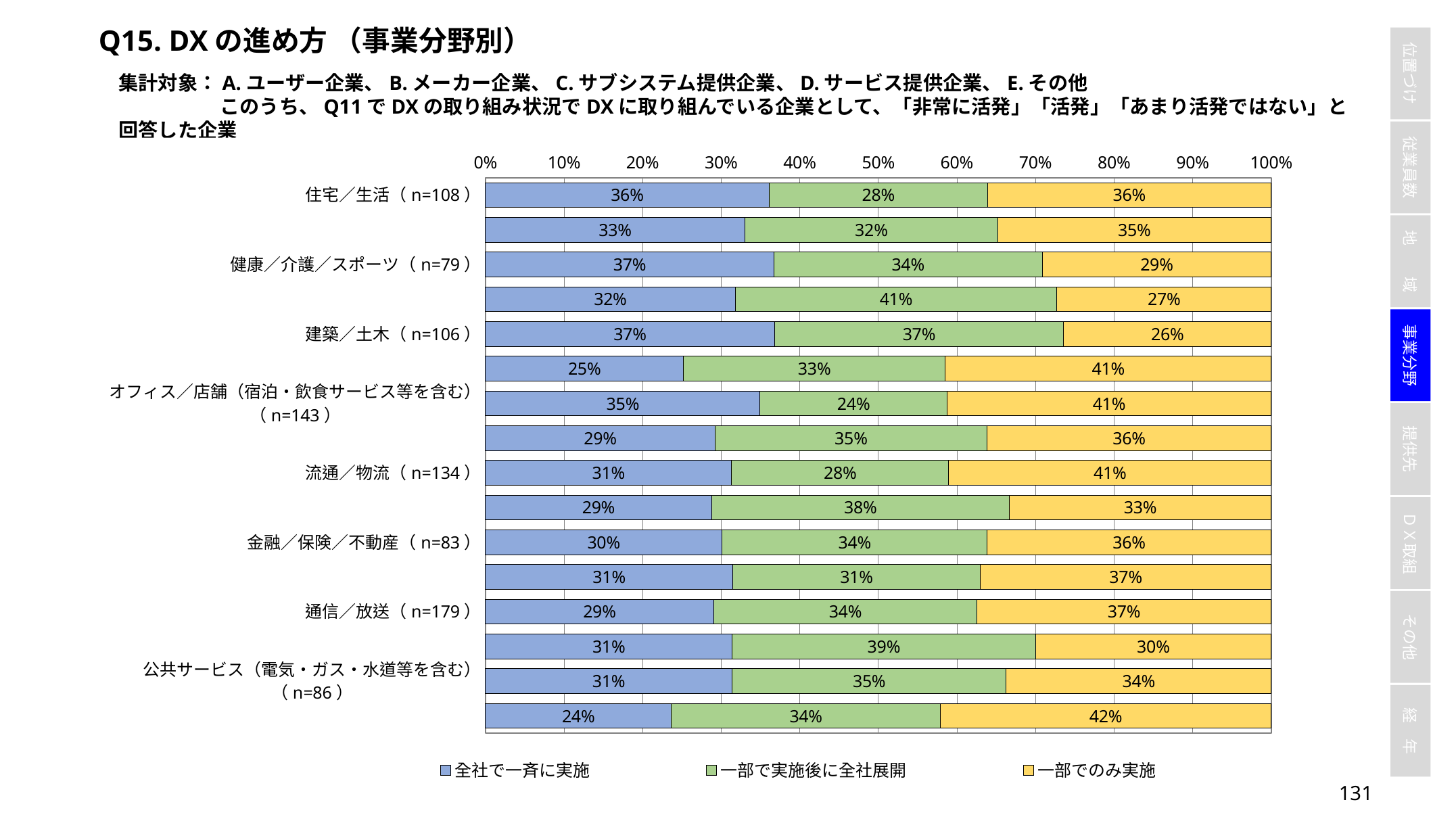
What kind of chart is shown on the slide? Stacked bar chart What is the value of 一部で実施後に全社展開 for 公共サービス（電気・ガス・水道等を含む）(n=86)? 35% How many series does the legend list? 3 For 建築／土木 (n=106), what is the difference between 一部で実施後に全社展開 and 一部でのみ実施? 11% For 流通／物流 (n=134), what is the difference between 一部でのみ実施 and 全社で一斉に実施? 10% What is the value of 一部で実施後に全社展開 for 健康／介護／スポーツ (n=79)? 34% Which category has the higher 全社で一斉に実施 value: 住宅／生活 (n=108) or 通信／放送 (n=179)? 住宅／生活 (n=108) What percentage of 住宅／生活 (n=108) companies chose 全社で一斉に実施? 36% What is the value of 一部でのみ実施 for オフィス／店舗（宿泊・飲食サービス等を含む）(n=143)? 41% What percentage of 通信／放送 (n=179) companies chose 全社で一斉に実施? 29% Which series is shown in yellow in the legend? 一部でのみ実施 Which is larger for 金融／保険／不動産 (n=83): 全社で一斉に実施 or 一部でのみ実施? 一部でのみ実施